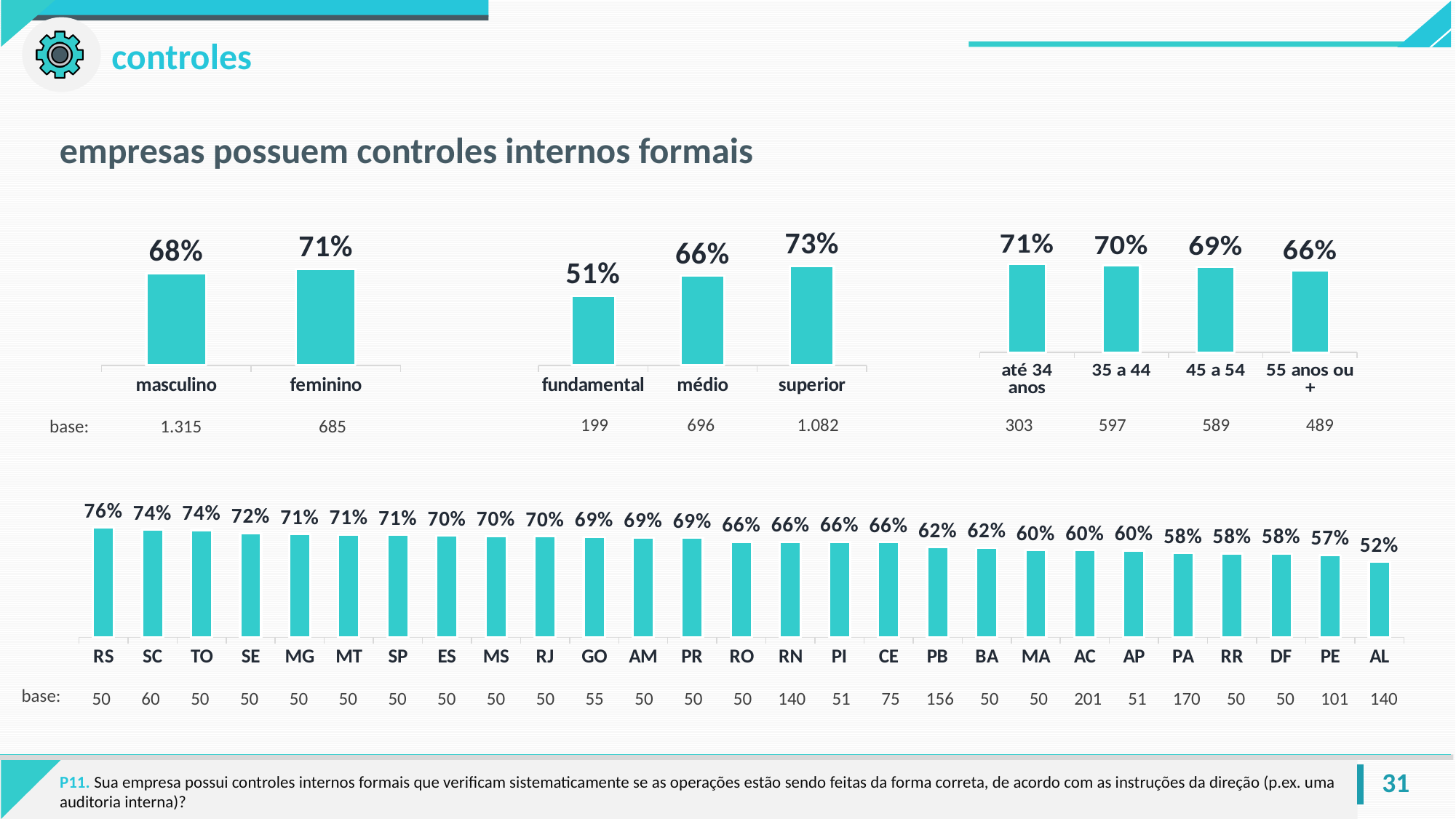
In the age chart at the top right, how many age categories are shown? 4 In the education chart at the top centre, do the values rise or fall from fundamental to superior? rise In the gender chart at the top left, what is the difference between feminino and masculino? 3 percentage points In the education chart at the top centre, which category has the lowest value? fundamental In the gender chart at the top left, what is the value for feminino? 71% In the state chart at the bottom, what is the value for PB? 62% In the state chart at the bottom, how many states are shown? 27 In the age chart at the top right, which age group has the highest value? até 34 anos In the state chart at the bottom, which state has the highest value? RS In the age chart at the top right, what is the value for 45 a 54? 69% In the state chart at the bottom, which state has the lowest value? AL In the education chart at the top centre, what is the value for superior? 73%